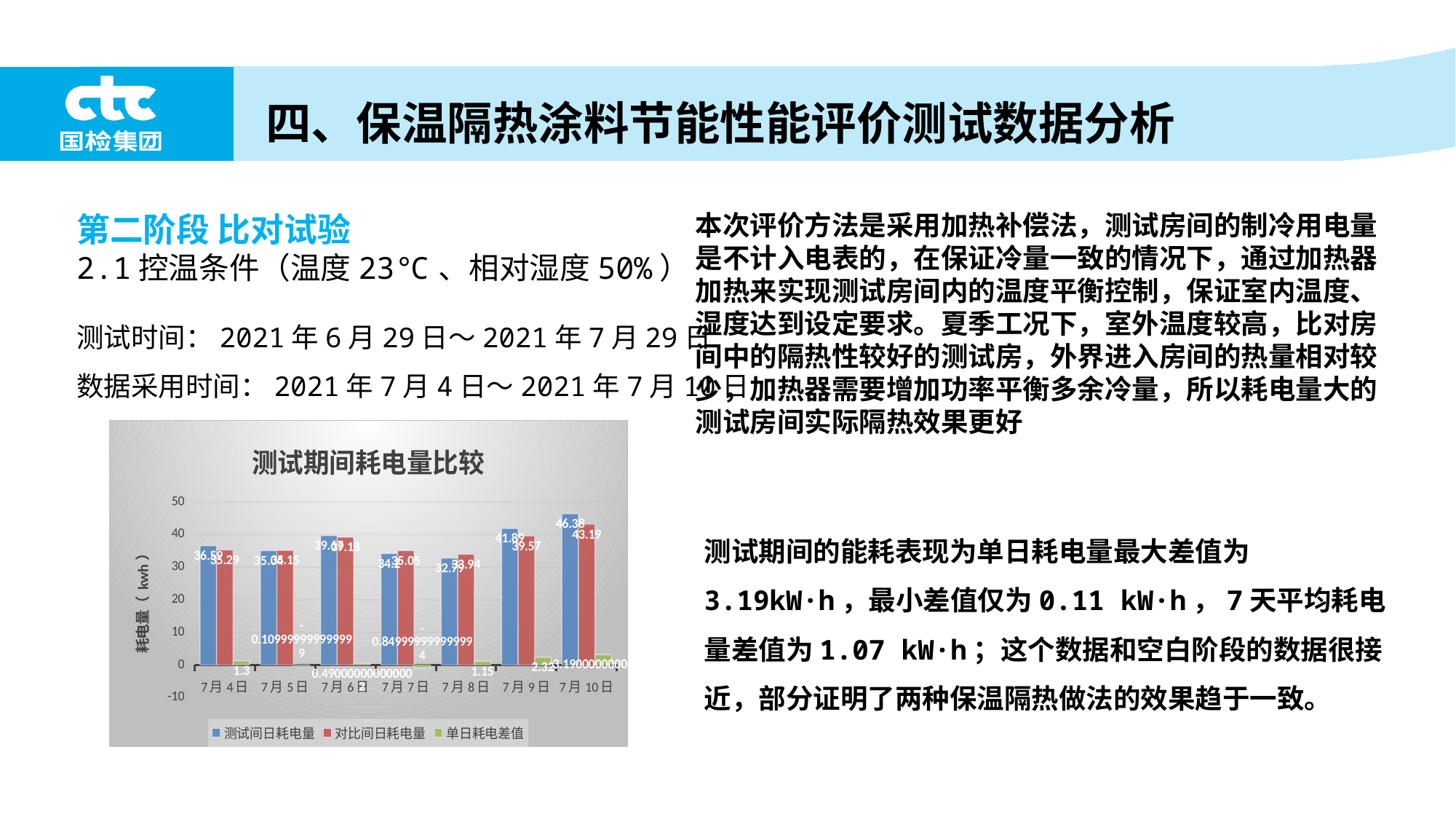
What is the value of 测试间日耗电量 on 7月10日? 46.38 What is the title of the chart? 测试期间耗电量比较 What is the value of 测试间日耗电量 on 7月9日? 41.89 How many dates are shown on the x axis of the chart? 7 How many series does the chart legend list? 3 On which date is 测试间日耗电量 the highest? 7月10日 What is the difference between 测试间日耗电量 and 对比间日耗电量 on 7月10日? 3.19 On which date is 测试间日耗电量 the lowest? 7月8日 What is the value of 对比间日耗电量 on 7月10日? 43.19 What is the value of 对比间日耗电量 on 7月9日? 39.57 What type of chart is shown on the slide? bar chart On 7月9日, which is larger: 测试间日耗电量 or 对比间日耗电量? 测试间日耗电量